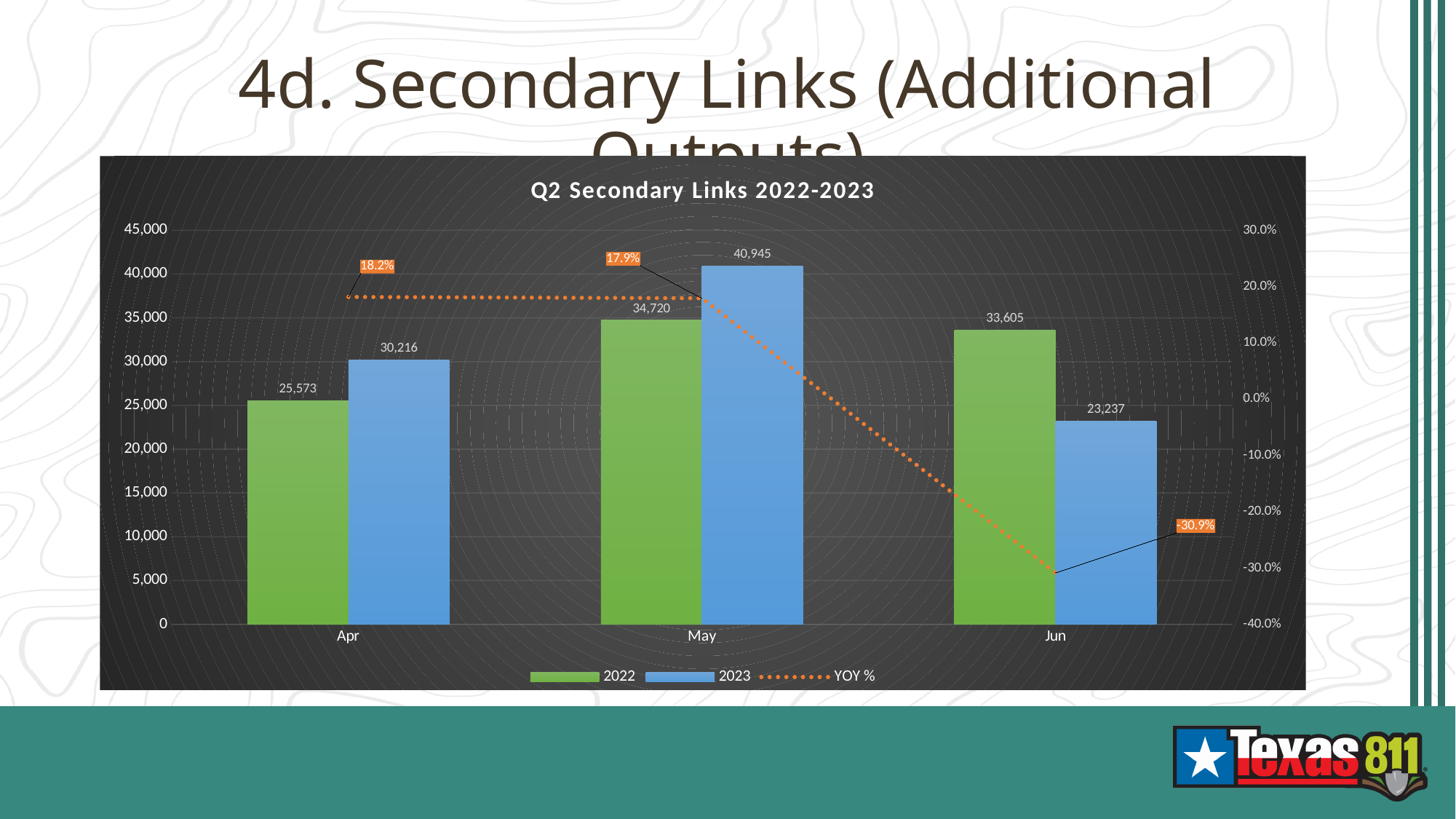
What is the YOY % value for Jun? -30.9% What is the value for 2023 in May? 40,945 What kind of chart is this? Bar chart with a line Which month has the lowest 2022 value? Apr How many series does the legend list? 3 Which month has the highest 2023 value? May How many months are shown on the x axis? 3 What is the value for 2022 in Apr? 25,573 Is the 2023 value for Apr greater or less than 30,000? greater What is the difference between the 2023 and 2022 values in May? 6,225 In Jun, which is larger, the 2022 value or the 2023 value? 2022 What is the title of the chart? Q2 Secondary Links 2022-2023